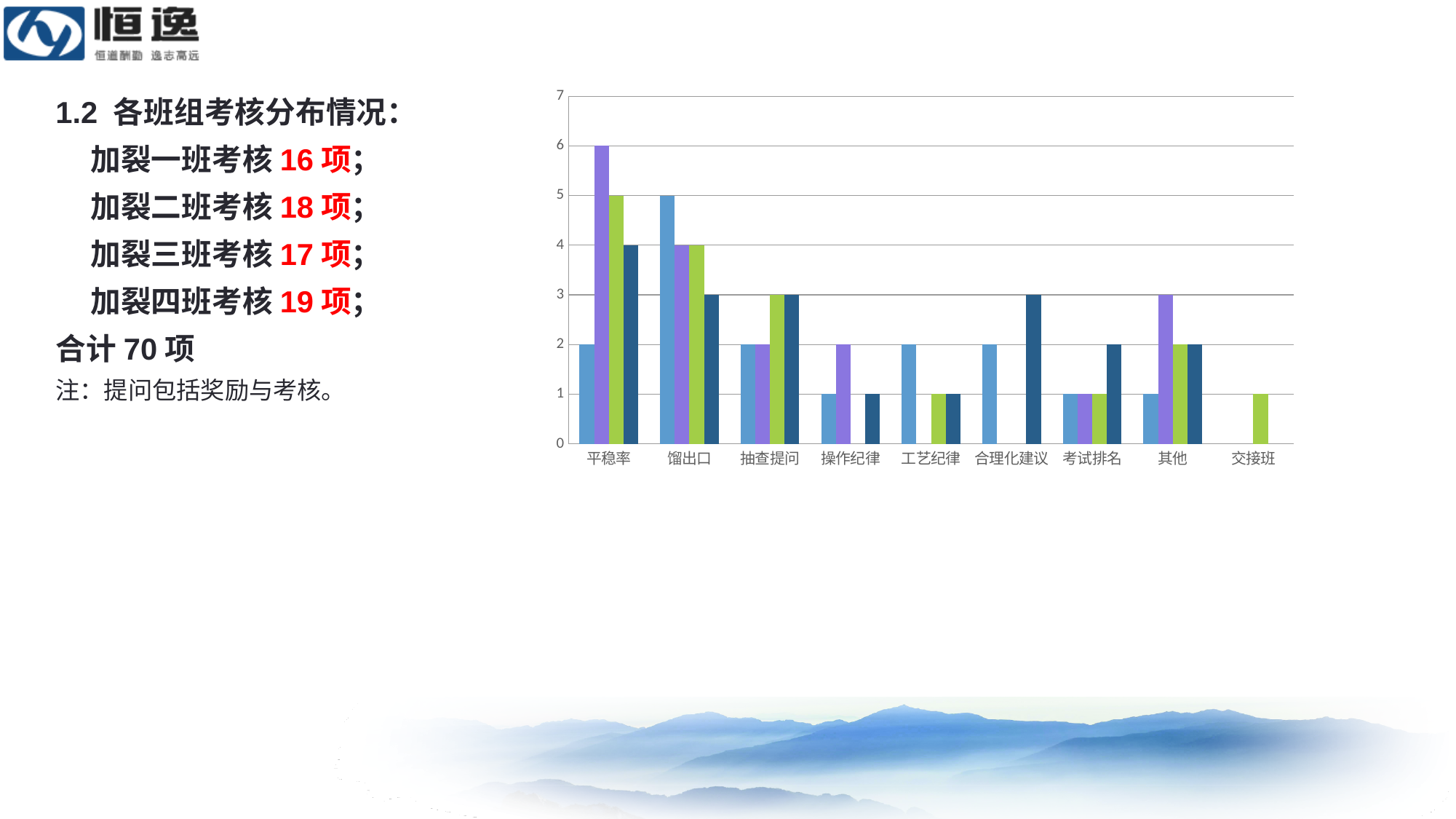
What is the maximum value shown on the vertical axis of the chart? 7 What is the value of the light blue bar for 馏出口? 5 What is the value of the green bar for 交接班? 1 Is the value of the green bar for 平稳率 greater or less than 4? greater What is the difference between the purple bar and the light blue bar for 平稳率? 4 Which is larger for 其他: the purple bar or the green bar? purple bar What is the value of the dark blue bar for 考试排名? 2 What is the value of the dark blue bar for 合理化建议? 3 Which category has the tallest bar in the chart? 平稳率 What kind of chart is shown on the slide? bar chart What is the value of the purple bar for 平稳率? 6 How many categories are shown on the x axis of the chart? 9